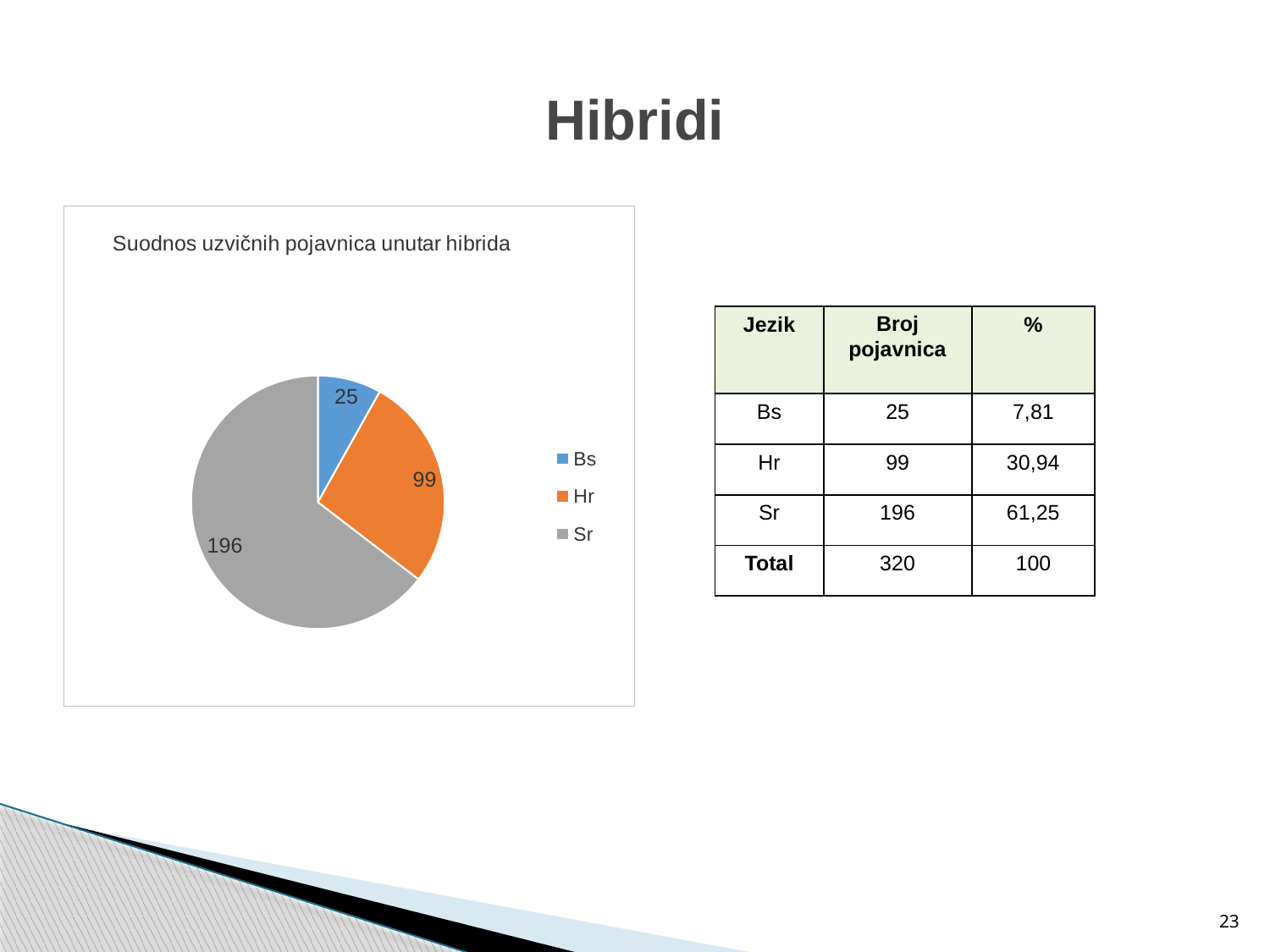
Which category has the smallest slice in the pie chart? Bs What is the value for Sr in the pie chart? 196 How many slices does the pie chart have? 3 Which category has the largest slice in the pie chart? Sr What type of chart is shown on the slide? pie chart Which is larger, the value for Hr or the value for Bs? Hr What is the value for Hr in the pie chart? 99 What colour is the Hr slice in the pie chart? orange What is the total of all slices in the pie chart? 320 What is the title of the chart? Suodnos uzvičnih pojavnica unutar hibrida What is the difference between the values for Sr and Hr? 97 What is the value for Bs in the pie chart? 25